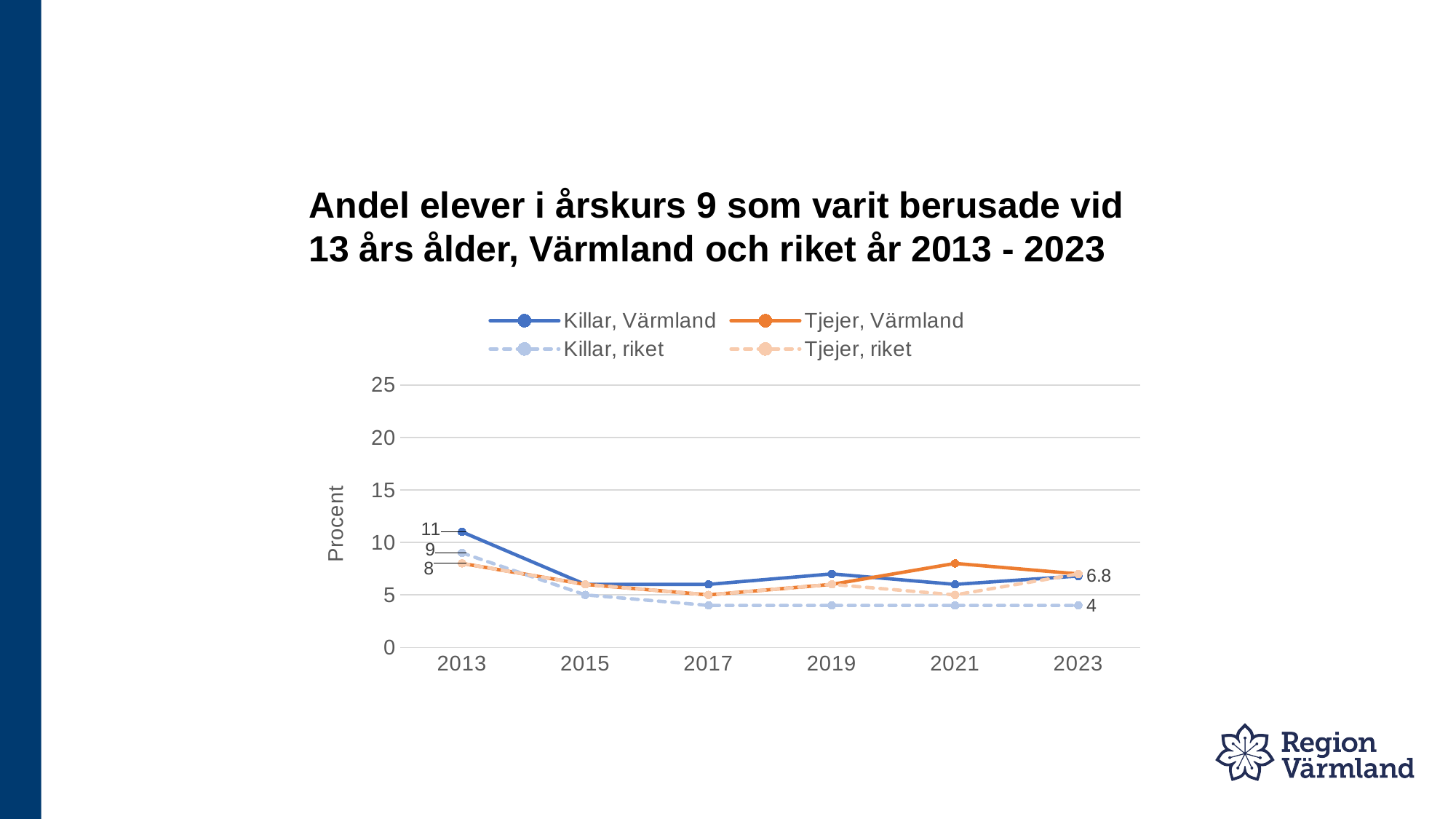
How many series does the legend list? 4 What is the difference between Killar, Värmland and Killar, riket in 2013? 2 What kind of chart is shown on the slide? Line chart Does the value for Killar, riket rise or fall from 2013 to 2023? Fall What is the label on the y axis? Procent What is the value for Killar, Värmland in 2013? 11 Is the value for Tjejer, Värmland in 2021 greater or less than 5? greater How many years are plotted along the x axis? 6 What is the value for Killar, riket in 2023? 4 What is the value for Killar, riket in 2013? 9 In which year is the value for Killar, Värmland highest? 2013 In 2013, which is larger: Killar, Värmland or Killar, riket? Killar, Värmland